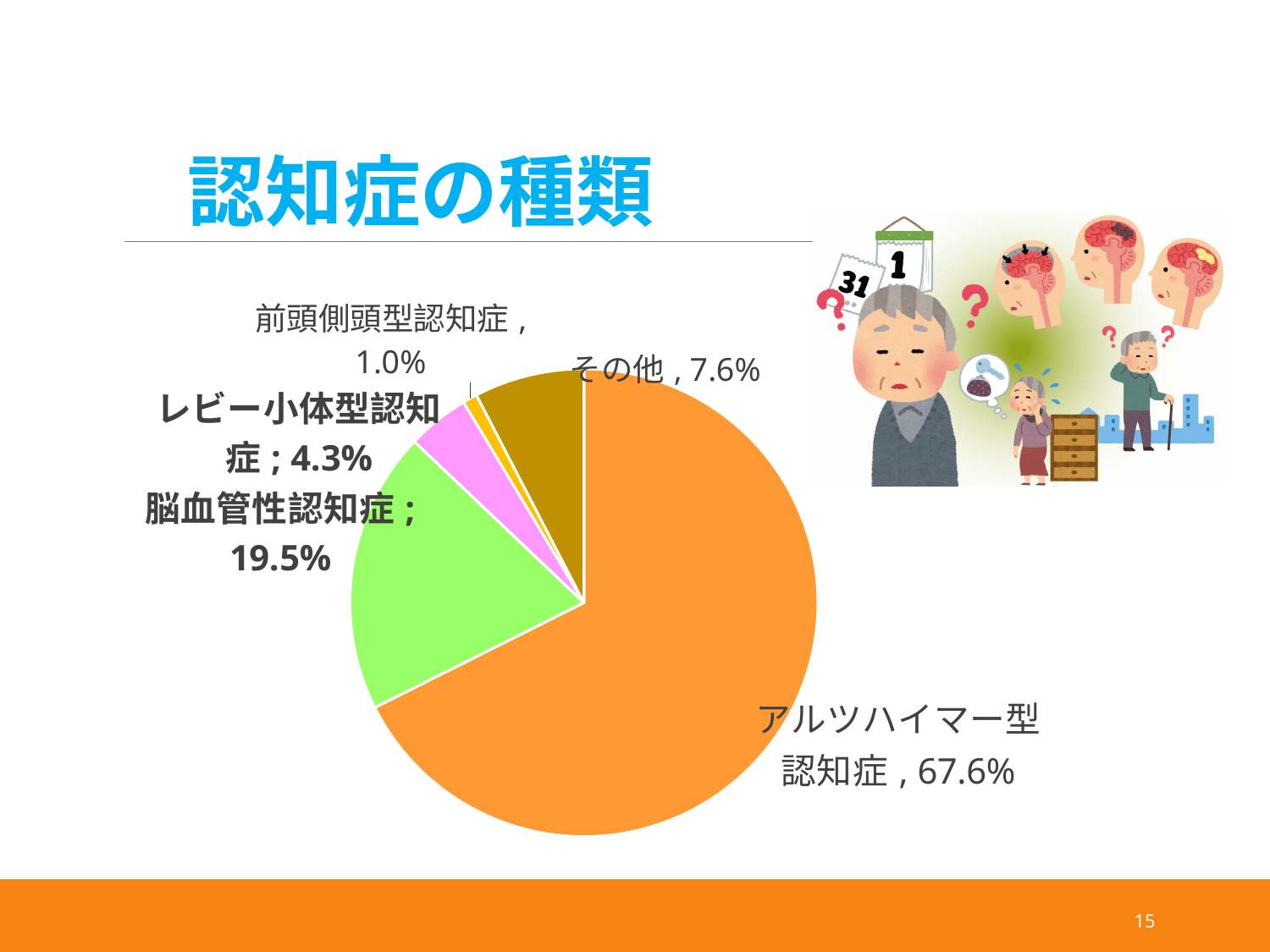
What is the difference between the values for アルツハイマー型認知症 and 脳血管性認知症? 48.1% What is the value for 前頭側頭型認知症? 1.0% What is the title of the slide containing the chart? 認知症の種類 What is the value for アルツハイマー型認知症? 67.6% What kind of chart is shown on the slide? pie chart How many categories are shown in the pie chart? 5 Which category has the smallest share of the pie? 前頭側頭型認知症 Which category has the largest share of the pie? アルツハイマー型認知症 Which is larger, その他 or レビー小体型認知症? その他 What is the value for その他? 7.6% What is the value for 脳血管性認知症? 19.5% What is the value for レビー小体型認知症? 4.3%